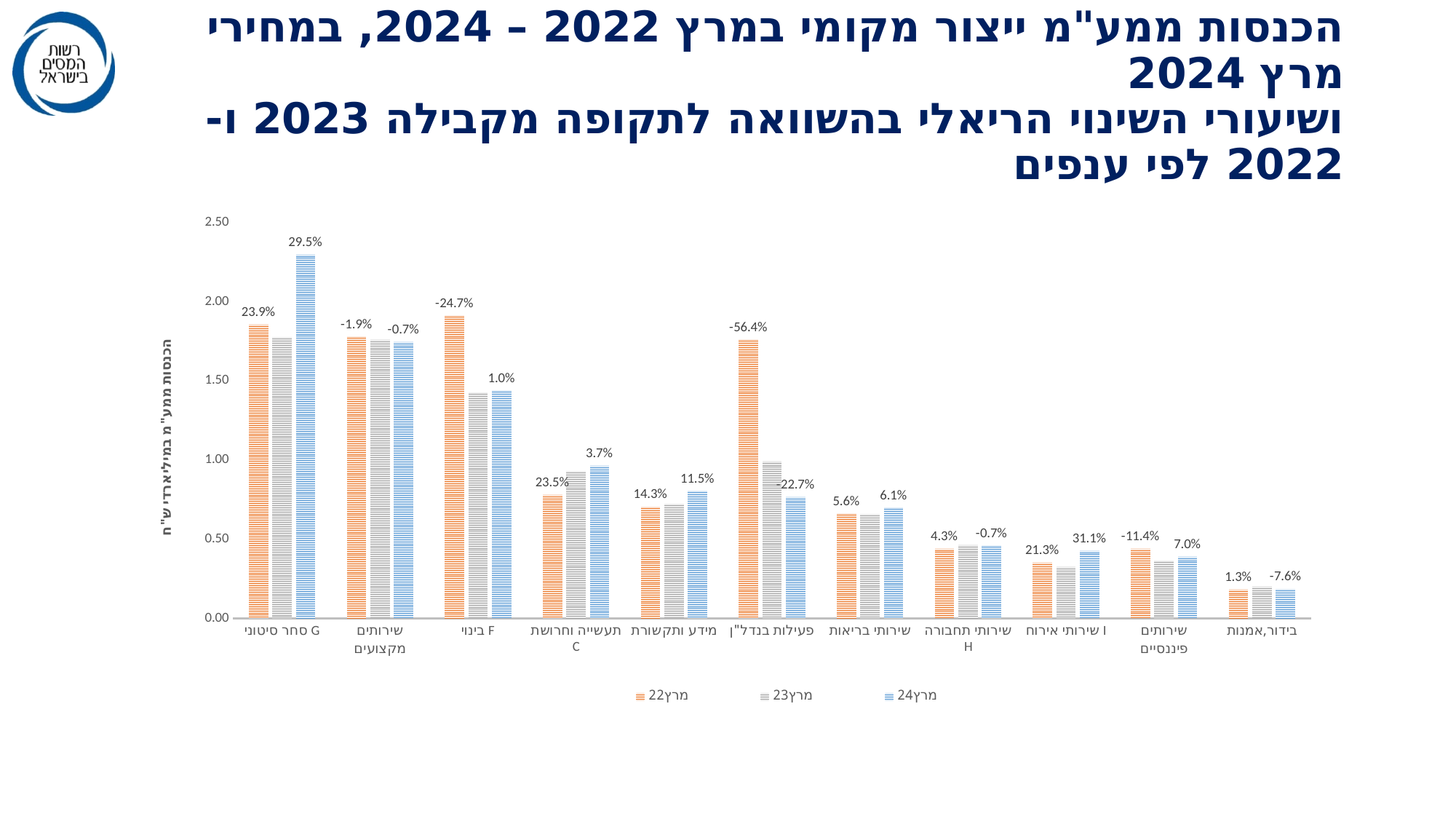
Which is larger: the מרץ24 bar for G סחר סיטוני or the מרץ24 bar for שירותים מקצועיים? G סחר סיטוני Which category has the lowest bars in the chart? בידור,אמנות How many categories (industry branches) are shown on the x axis? 11 Is the מרץ24 bar for G סחר סיטוני greater or less than 2.00? greater Is the מרץ22 bar for בידור,אמנות greater or less than 0.50? less What is the lowest percentage label printed on the chart, and for which category? -56.4%, פעילות בנדל"ן How many series does the legend list? 3 What kind of chart is shown on the slide? bar chart What percentage label is printed above the מרץ24 bar for G סחר סיטוני? 29.5% Which category has the tallest bar in the chart? G סחר סיטוני Is the מרץ22 bar for F בינוי greater or less than 1.50? greater What is the title of the vertical axis? הכנסות ממע"מ במיליארדי ש"ח